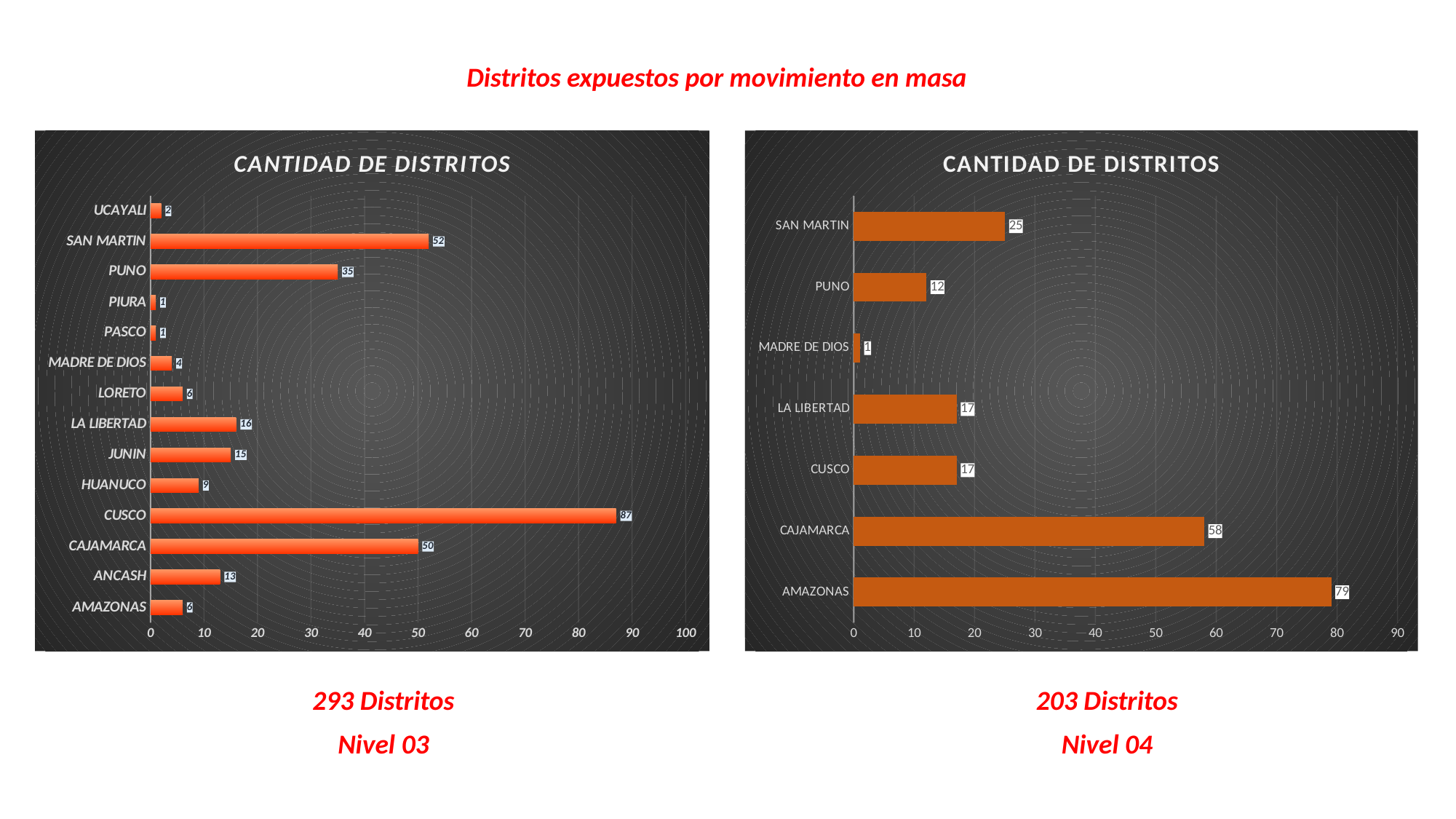
How many categories are shown in the right chart (Nivel 04)? 7 How many categories are shown in the left chart (Nivel 03)? 14 In the right chart (Nivel 04), which category has the lowest value? MADRE DE DIOS What type of chart is the left chart (Nivel 03)? Bar chart In the right chart (Nivel 04), what is the difference between the values for AMAZONAS and CAJAMARCA? 21 In the left chart (Nivel 03), what is the value for CUSCO? 87 In the left chart (Nivel 03), which category has the highest value? CUSCO In the left chart (Nivel 03), what is the difference between the values for CUSCO and CAJAMARCA? 37 In the left chart (Nivel 03), which is larger, the value for PUNO or the value for LA LIBERTAD? PUNO In the left chart (Nivel 03), what is the value for SAN MARTIN? 52 In the right chart (Nivel 04), what is the value for CAJAMARCA? 58 In the right chart (Nivel 04), which category has the highest value? AMAZONAS